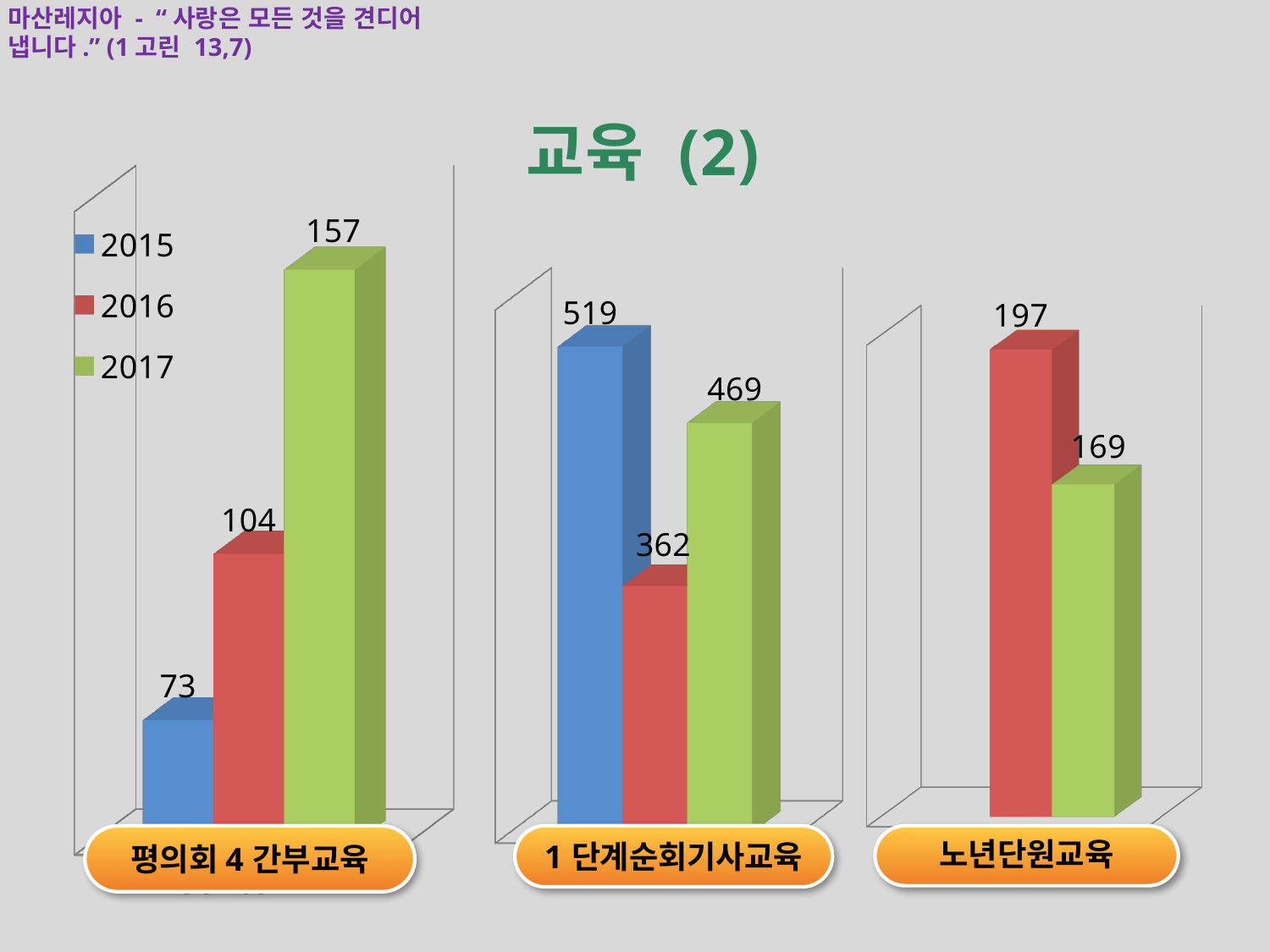
In the 평의회 4 간부교육 chart, do the values rise or fall from 2015 to 2017? rise What kind of chart is the 1 단계순회기사교육 chart? bar chart In the 1 단계순회기사교육 chart, what is the difference between the 2015 and 2017 values? 50 In the 평의회 4 간부교육 chart, what is the value for 2017? 157 In the 노년단원교육 chart, what is the value for 2017? 169 In the 1 단계순회기사교육 chart, which year has the highest value? 2015 In the 1 단계순회기사교육 chart, what is the value for 2016? 362 In the 노년단원교육 chart, what is the difference between the 2016 and 2017 values? 28 In the 평의회 4 간부교육 chart, which is larger, the value for 2016 or the value for 2017? 2017 In the 평의회 4 간부교육 chart, which year has the lowest value? 2015 How many series does the legend list? 3 How many bars are shown in the 노년단원교육 chart? 2